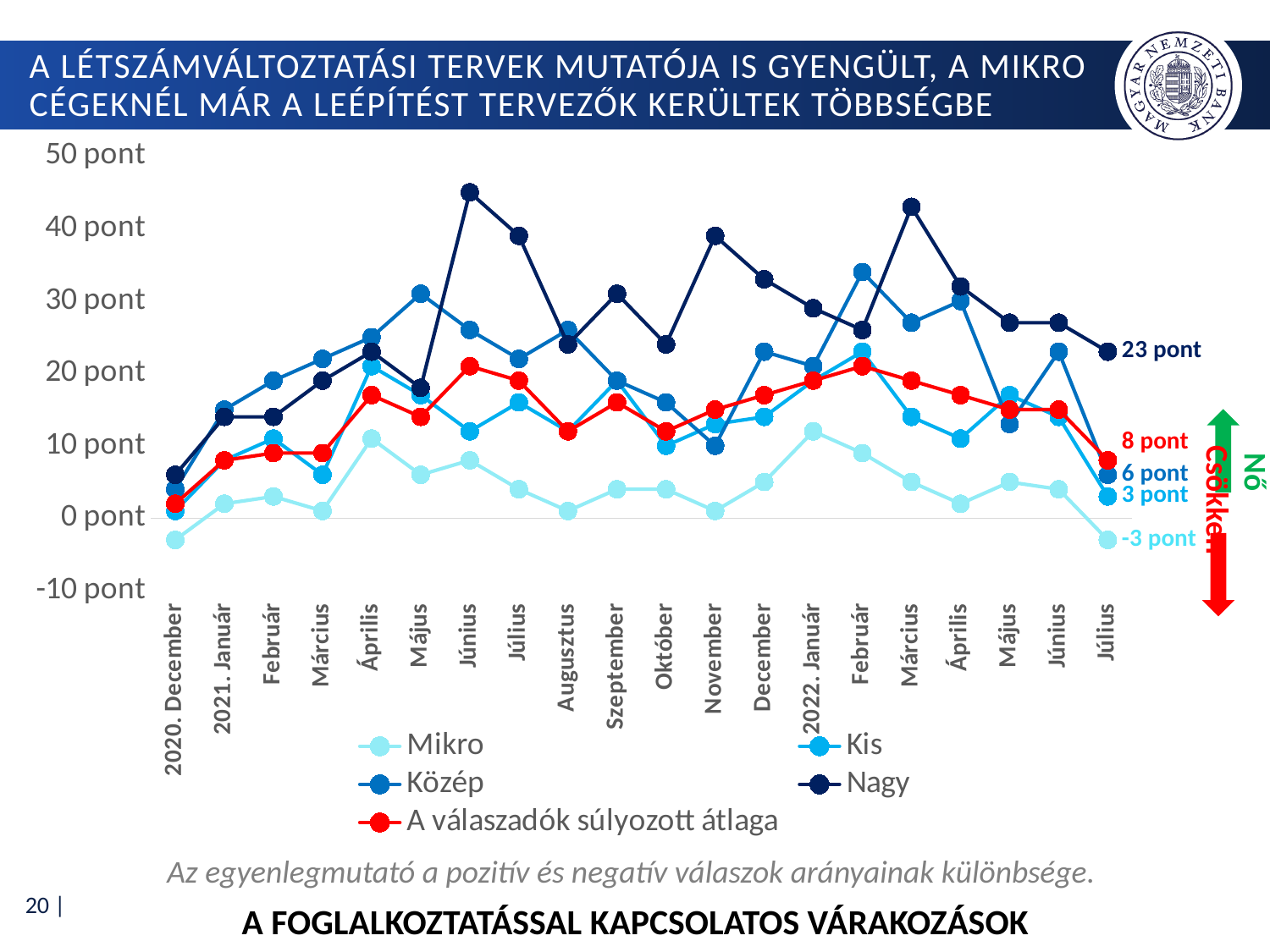
What kind of chart is shown on the slide? line chart Does the Nagy series rise or fall from 2022 Március to 2022 Július? fall Is the value for Nagy in 2021 Június greater or less than 40 pont? greater Which series has the highest value in 2022 Július? Nagy What is the value of 'A válaszadók súlyozott átlaga' in 2022 Július? 8 pont What is the value for the Nagy series in 2022 Július? 23 pont In 2022 Július, which is larger: the Közép value or the Kis value? Közép What is the difference between the Nagy and Mikro values in 2022 Július? 26 pont What is the value for the Kis series in 2022 Július? 3 pont How many series does the legend list? 5 What is the value for the Mikro series in 2022 Július? -3 pont Which series has the lowest value in 2022 Július? Mikro